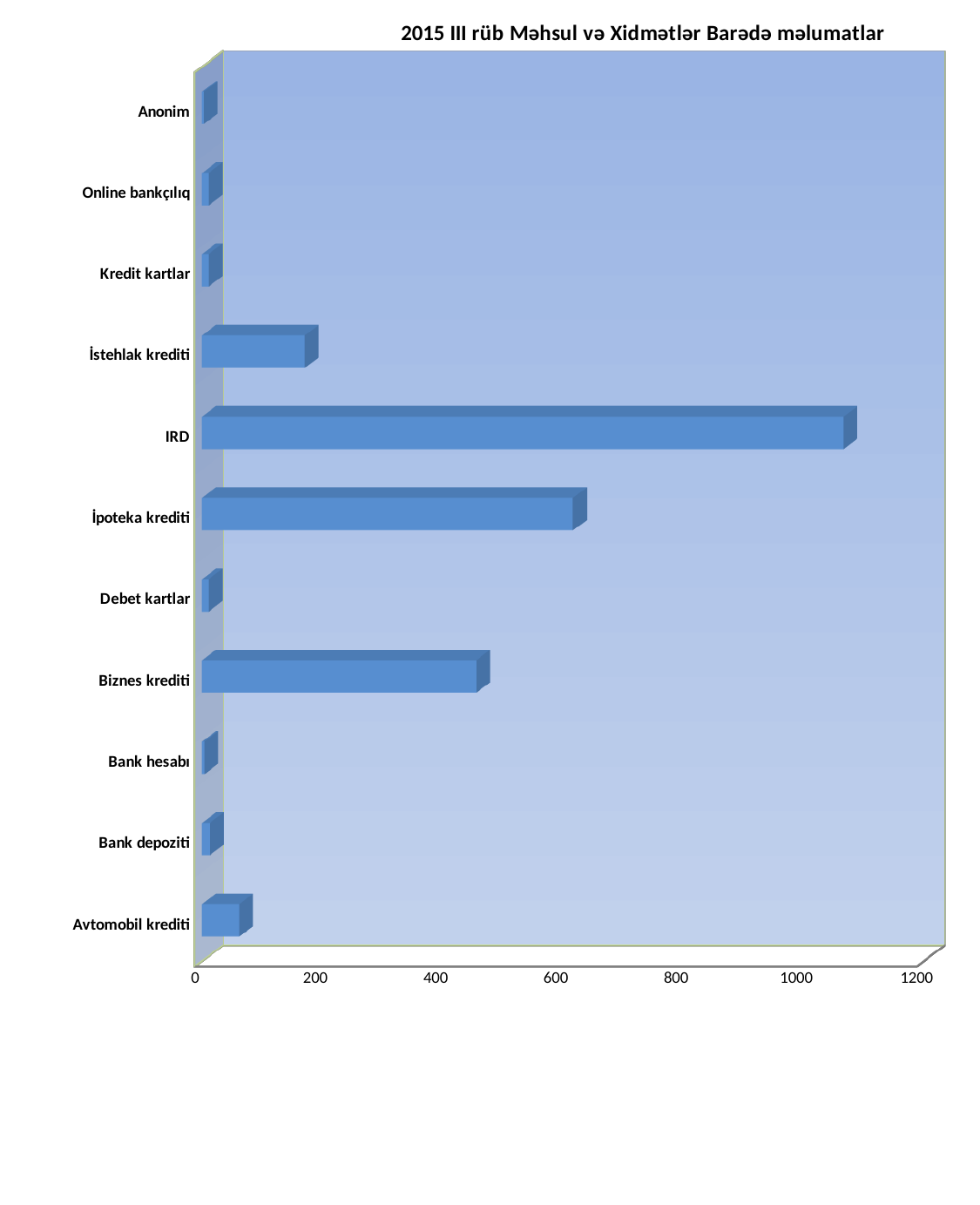
Is the value for Biznes krediti greater or less than 600? less Is the value for Biznes krediti greater or less than 400? greater What type of chart is shown on the slide? bar chart Is the value for Avtomobil krediti greater or less than 200? less What is the maximum value shown on the horizontal axis? 1200 What is the title of the chart? 2015 III rüb Məhsul və Xidmətlər Barədə məlumatlar How many categories are shown in the chart? 11 Which category has the highest value? IRD Which is larger, the value for İpoteka krediti or the value for Biznes krediti? İpoteka krediti